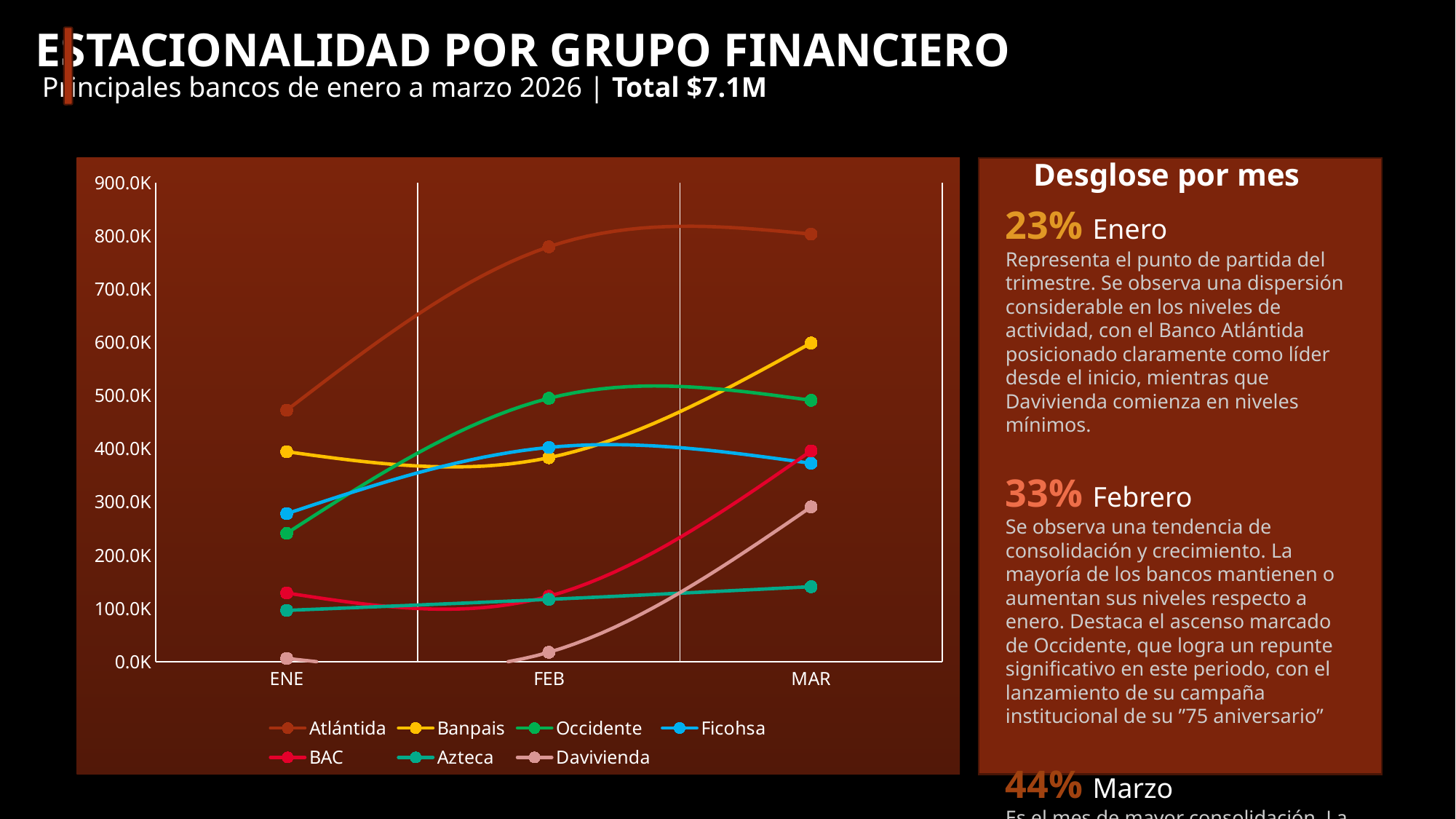
What colour is the Banpais line in the chart? Yellow In FEB, which is larger: the value for Occidente or the value for Ficohsa? Occidente Is the value for Banpais in MAR greater or less than 500.0K? greater How many series does the chart legend list? 7 Which bank has the highest value in ENE? Atlántida Which bank has the lowest value in ENE? Davivienda Does the Davivienda line rise or fall from ENE to MAR? Rises How many months are plotted along the x axis? 3 Is the value for Davivienda in ENE greater or less than 100.0K? less What kind of chart is shown on the slide? Line chart Which bank has the highest value in MAR? Atlántida Is the value for Atlántida in FEB greater or less than 700.0K? greater